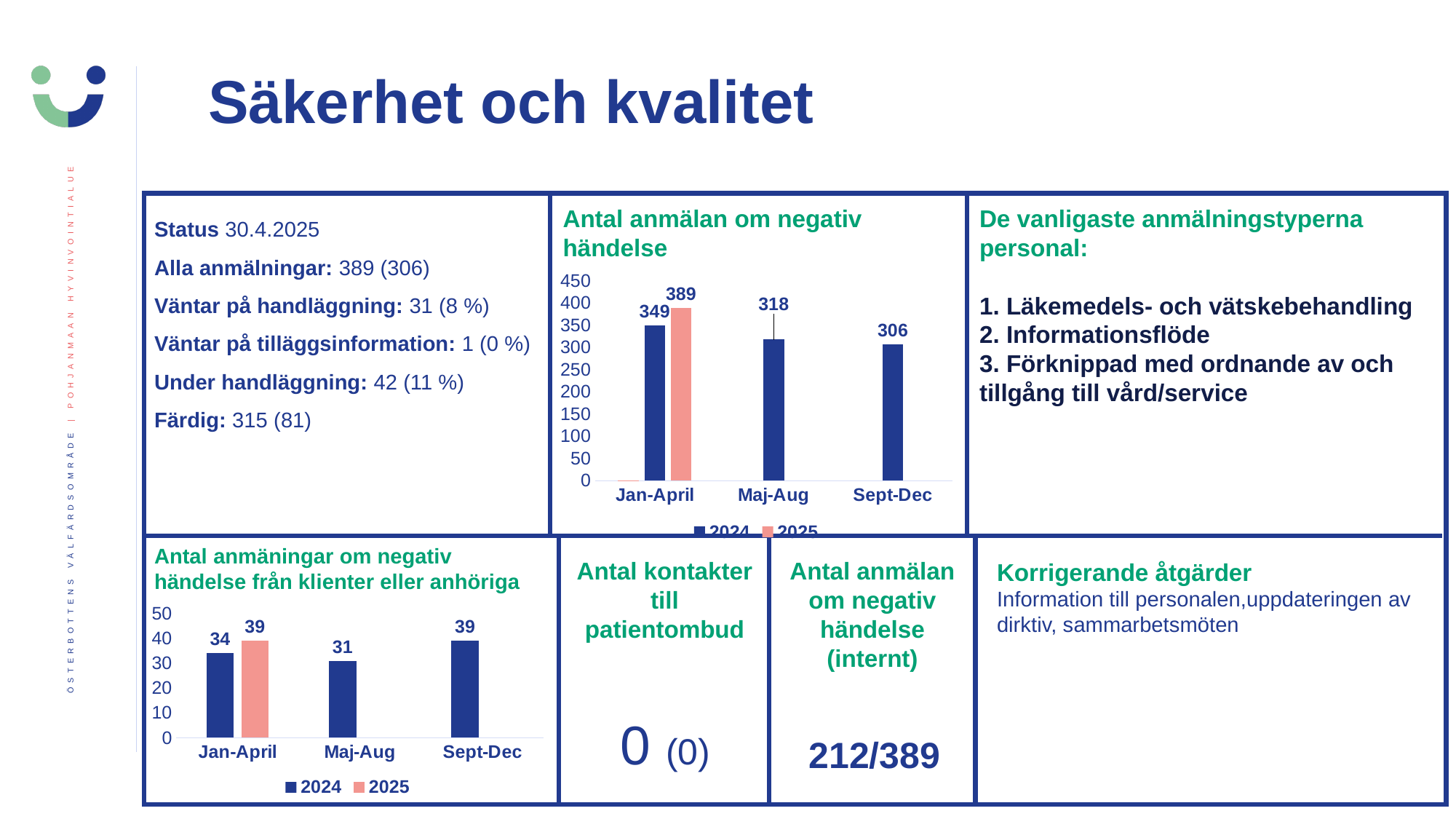
In the chart 'Antal anmälan om negativ händelse', what is the 2024 value for Jan-April? 349 In the chart 'Antal anmälan om negativ händelse', how many series does the legend list? 2 In the chart 'Antal anmäningar om negativ händelse från klienter eller anhöriga', what is the 2025 value for Jan-April? 39 In the chart 'Antal anmälan om negativ händelse', what is the difference between the 2025 and 2024 values for Jan-April? 40 In the chart 'Antal anmälan om negativ händelse', is the 2024 value for Maj-Aug greater or less than 300? greater In the chart 'Antal anmälan om negativ händelse', what is the 2025 value for Jan-April? 389 In the chart 'Antal anmäningar om negativ händelse från klienter eller anhöriga', what is the 2024 value for Maj-Aug? 31 In the chart 'Antal anmälan om negativ händelse', which period has the lowest 2024 value? Sept-Dec In the chart 'Antal anmäningar om negativ händelse från klienter eller anhöriga', what is the difference between the 2025 and 2024 values for Jan-April? 5 In the chart 'Antal anmälan om negativ händelse', what is the 2024 value for Sept-Dec? 306 In the chart 'Antal anmäningar om negativ händelse från klienter eller anhöriga', which is larger: the 2024 value for Jan-April or the 2024 value for Sept-Dec? Sept-Dec What type of chart is 'Antal anmäningar om negativ händelse från klienter eller anhöriga'? Bar chart